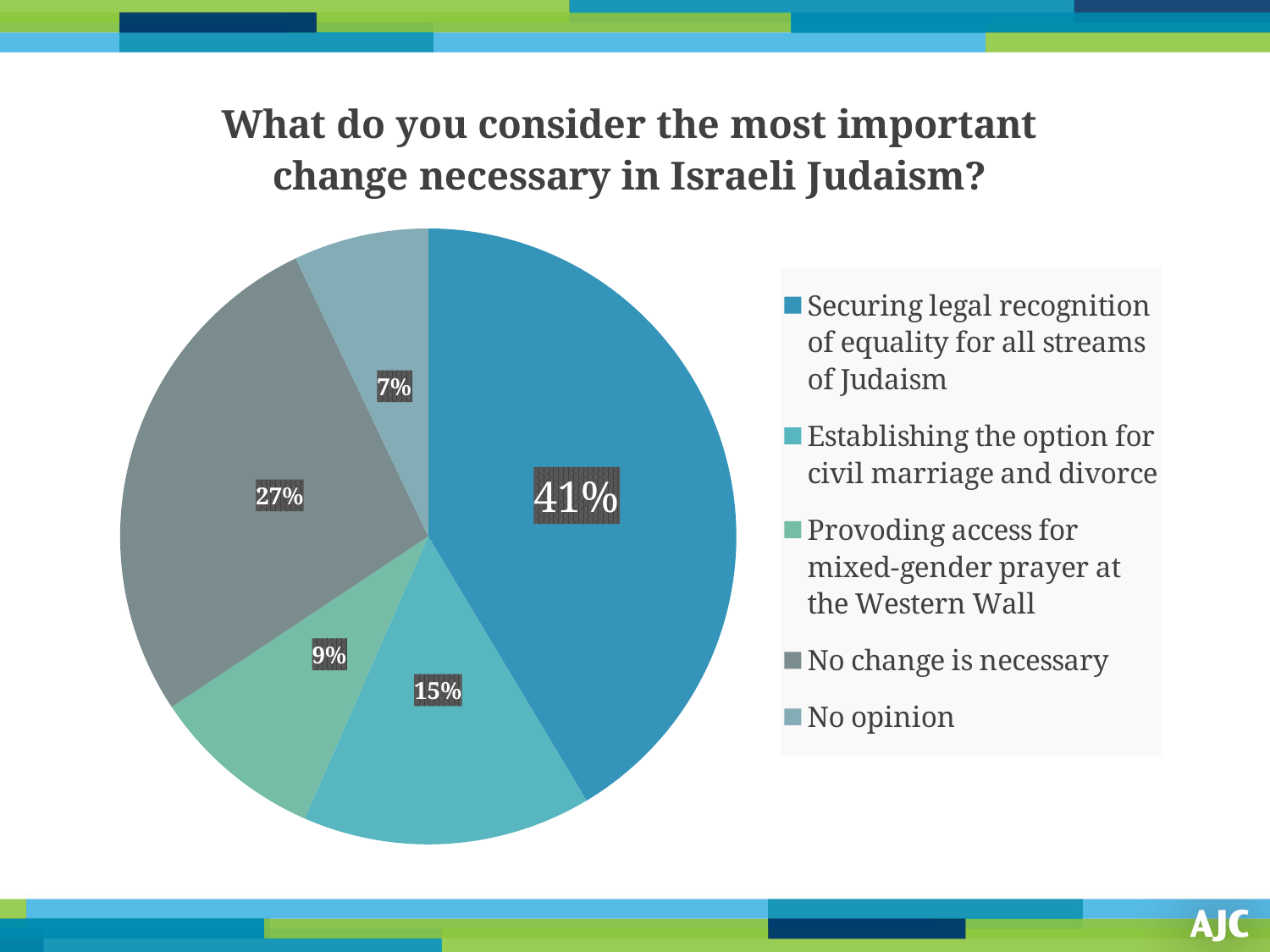
What share of respondents chose "Establishing the option for civil marriage and divorce"? 15% What share of respondents had "No opinion"? 7% What share of respondents chose "Securing legal recognition of equality for all streams of Judaism"? 41% How many slices does the pie chart have? 5 What is the title of the chart? What do you consider the most important change necessary in Israeli Judaism? What is the difference in percentage points between "Securing legal recognition of equality for all streams of Judaism" and "No change is necessary"? 14 What kind of chart is shown on the slide? pie chart What share of respondents chose "Provoding access for mixed-gender prayer at the Western Wall"? 9% What share of respondents said "No change is necessary"? 27% Which is larger: the share for "Establishing the option for civil marriage and divorce" or the share for "Provoding access for mixed-gender prayer at the Western Wall"? Establishing the option for civil marriage and divorce Which response has the largest slice of the pie? Securing legal recognition of equality for all streams of Judaism Which response has the smallest slice of the pie? No opinion